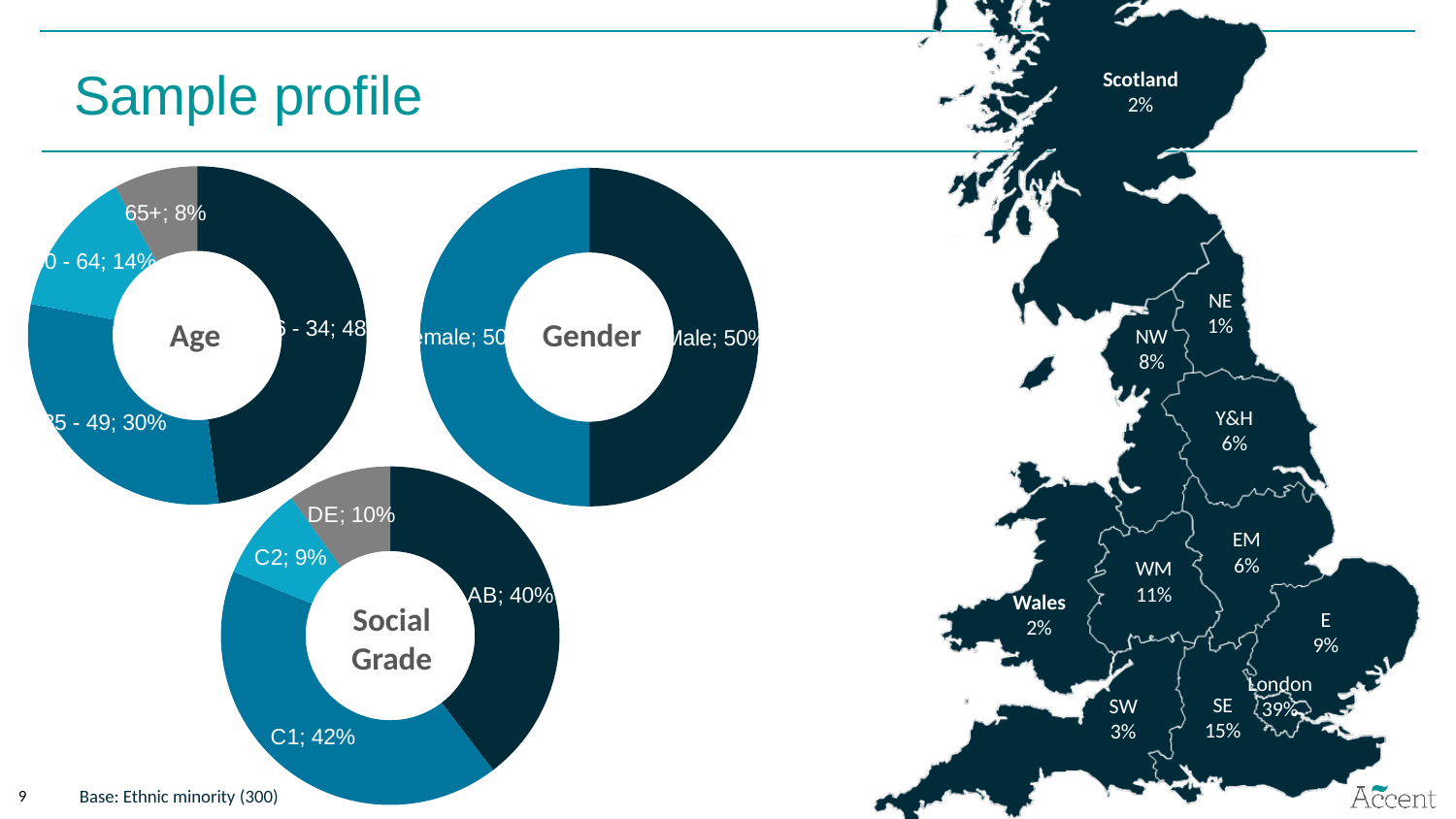
In the Social Grade chart, what is the difference in percentage points between C1 and AB? 2 percentage points In the Social Grade chart, what percentage is shown for C2? 9% In the Social Grade chart, which is larger, DE or C2? DE In the Social Grade chart, what percentage is shown for AB? 40% What type of chart is used for the Age, Gender and Social Grade breakdowns? Donut (pie) chart In the Age chart, what percentage is shown for the 65+ group? 8% In the Social Grade chart, what percentage is shown for DE? 10% How many categories does the Social Grade chart show? 4 In the Social Grade chart, which category has the largest share? C1 In the Gender chart, what percentage is shown for Male? 50% In the Social Grade chart, what percentage is shown for C1? 42% In the Social Grade chart, which category has the smallest share? C2